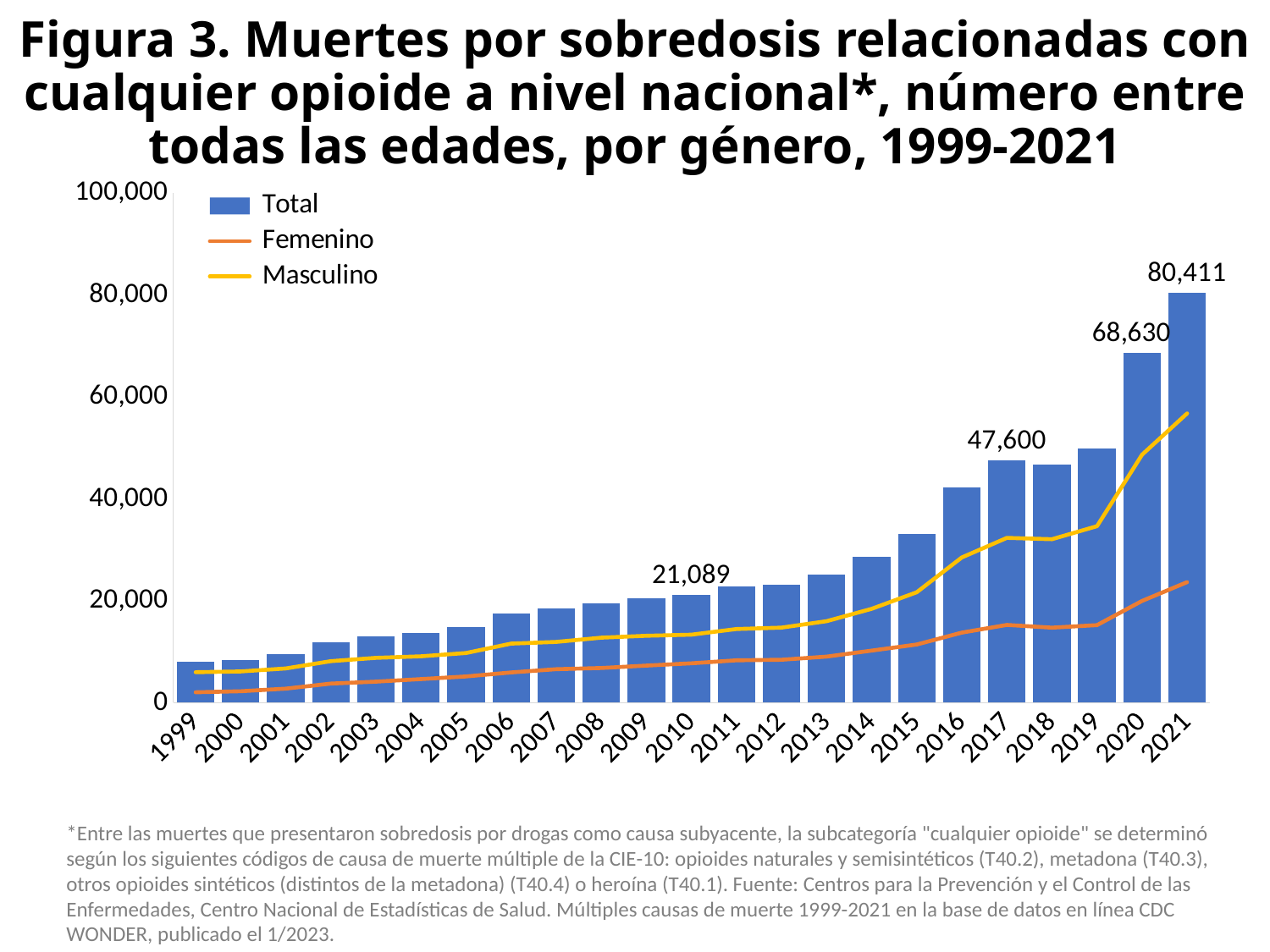
Is the Total value for 2015 greater or less than 40,000? less What is the Total value labeled for 2017? 47,600 What is the Total value labeled for 2020? 68,630 How many years are shown on the x axis? 23 What is the Total number of opioid-related overdose deaths shown for 2021? 80,411 Does the Total generally rise or fall from 1999 to 2021? rise What is the Total value labeled for 2010? 21,089 What is the difference between the Total for 2020 and the Total for 2017? 21,030 By how much did the Total increase from 2020 to 2021? 11,781 In 2021, which series is higher, Masculino or Femenino? Masculino How many series does the legend list? 3 Which year has the highest Total? 2021